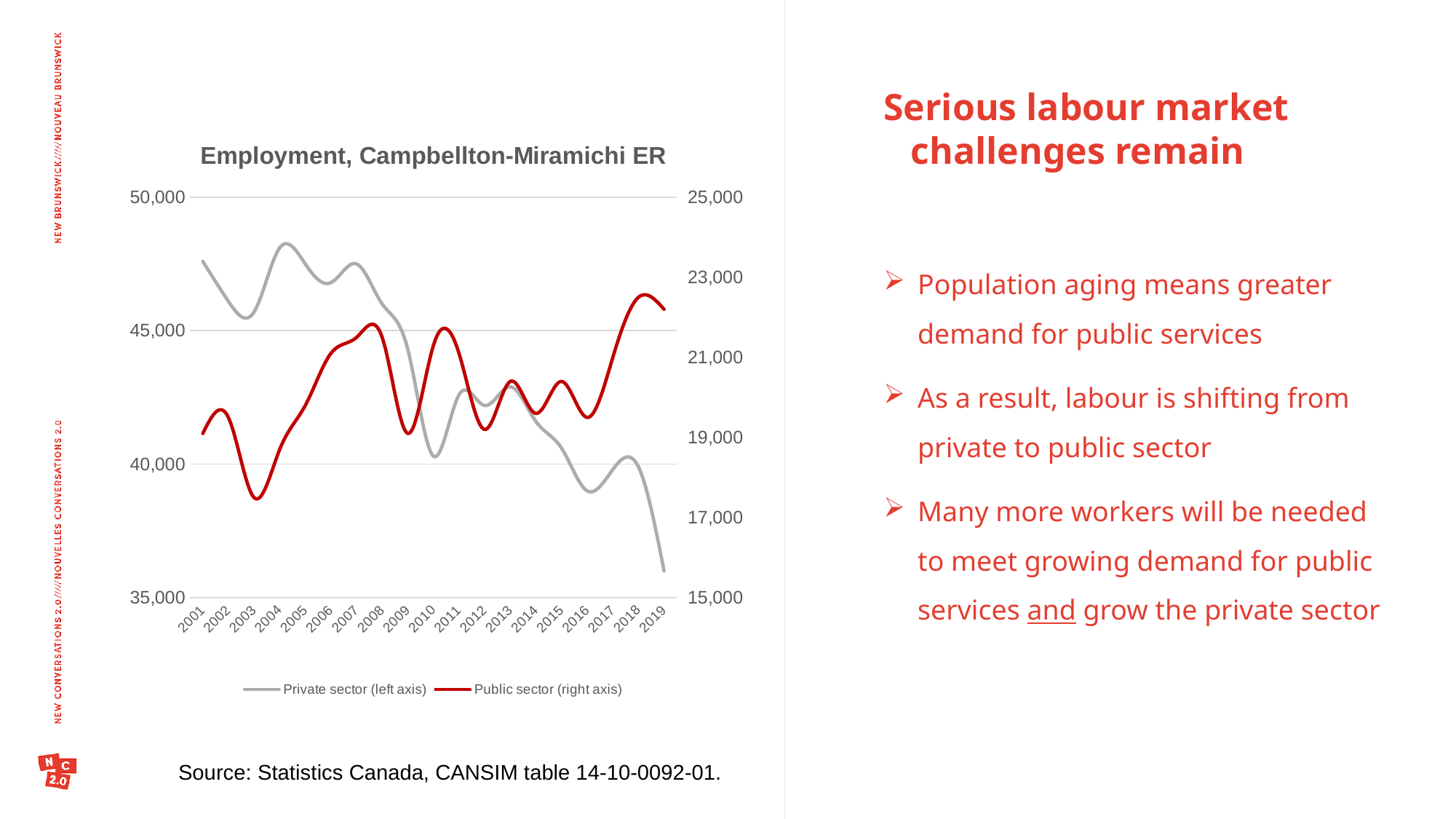
How many series does the chart's legend list? 2 Does the Private sector line rise or fall overall from 2001 to 2019? Fall Which series is plotted against the right axis? Public sector What is the title of the chart? Employment, Campbellton-Miramichi ER In which year is Private sector employment lowest? 2019 Is the Private sector value for 2019 greater or less than 40,000? less What kind of chart is shown on the slide? Line chart Which is larger, Private sector employment in 2001 or in 2019? 2001 In which year is Public sector employment lowest? 2003 Does the Public sector line rise or fall overall from 2001 to 2019? Rise How many years are shown along the x axis? 19 Is the Public sector value for 2018 greater or less than 21,000? greater